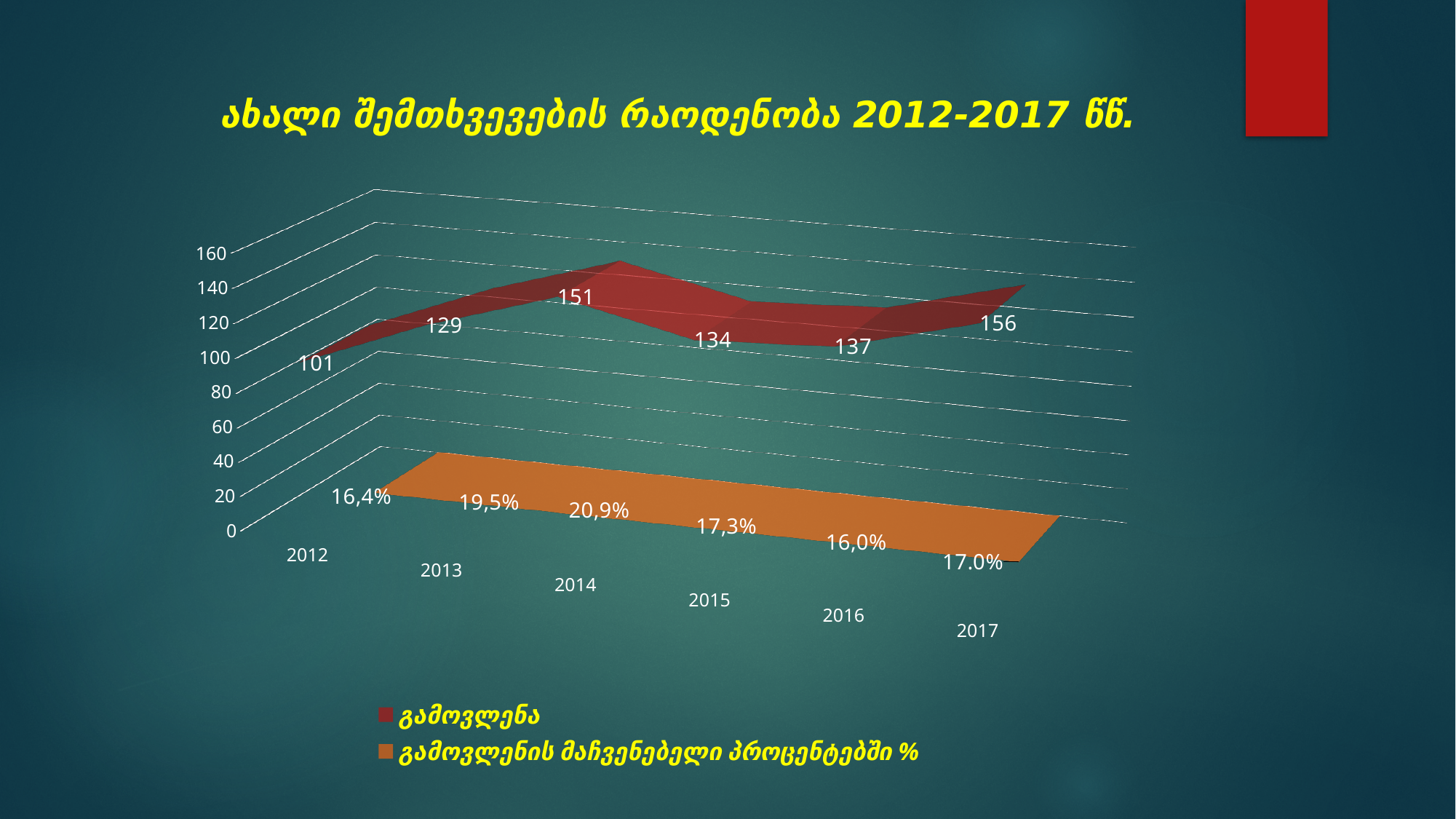
What is the value of the გამოვლენის მაჩვენებელი პროცენტებში % series for 2014? 20,9% In which year is the გამოვლენის მაჩვენებელი პროცენტებში % series highest? 2014 How many years are shown on the x axis? 6 What is the value of the გამოვლენის მაჩვენებელი პროცენტებში % series for 2016? 16,0% How many series does the legend list? 2 In which year is the გამოვლენა series lowest? 2012 Which is larger, the გამოვლენა value for 2014 or for 2015? 2014 What is the title of the chart? ახალი შემთხვევების რაოდენობა 2012-2017 წწ. In which year is the გამოვლენა series highest? 2017 What is the difference between the გამოვლენა values for 2017 and 2012? 55 What is the value of the გამოვლენა series for 2017? 156 What is the value of the გამოვლენა series for 2012? 101